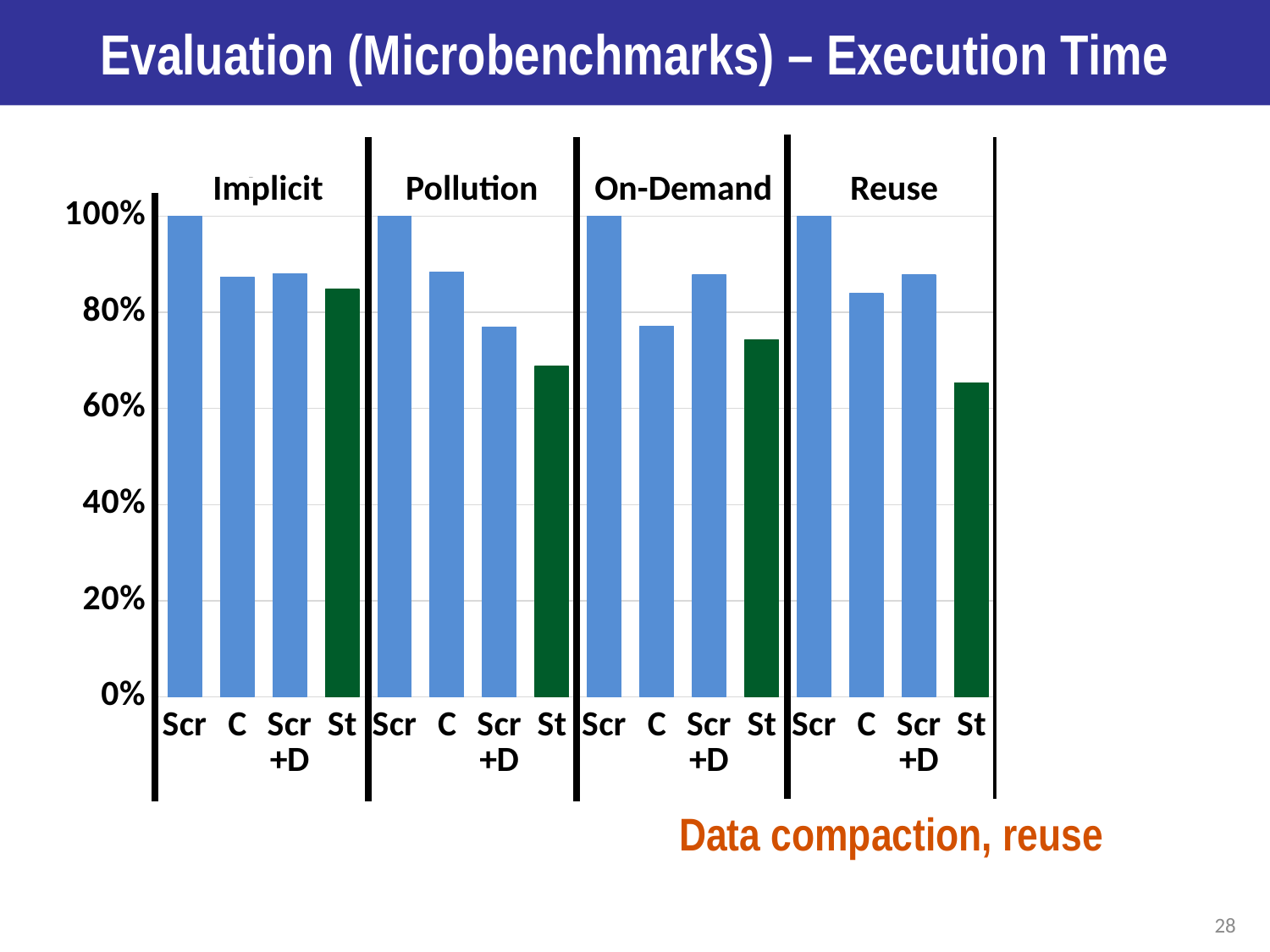
Which is larger: the St bar in the Implicit group or the St bar in the Reuse group? Implicit St What is the value of the Scr bar in the Reuse group? 100% Which bar is the highest in the Pollution group? Scr How many benchmark groups are shown in the chart? 4 What kind of chart is shown on the slide? bar chart Which bar is the lowest in the Reuse group? St Is the value of the C bar in the On-Demand group greater or less than 80%? less What is the value of the Scr bar in the Implicit group? 100% In the Pollution group, which is larger: the C bar or the St bar? C Is the value of the Scr+D bar in the Implicit group greater or less than 80%? greater Which bar is the lowest in the Pollution group? St Is the value of the St bar in the Reuse group greater or less than 80%? less